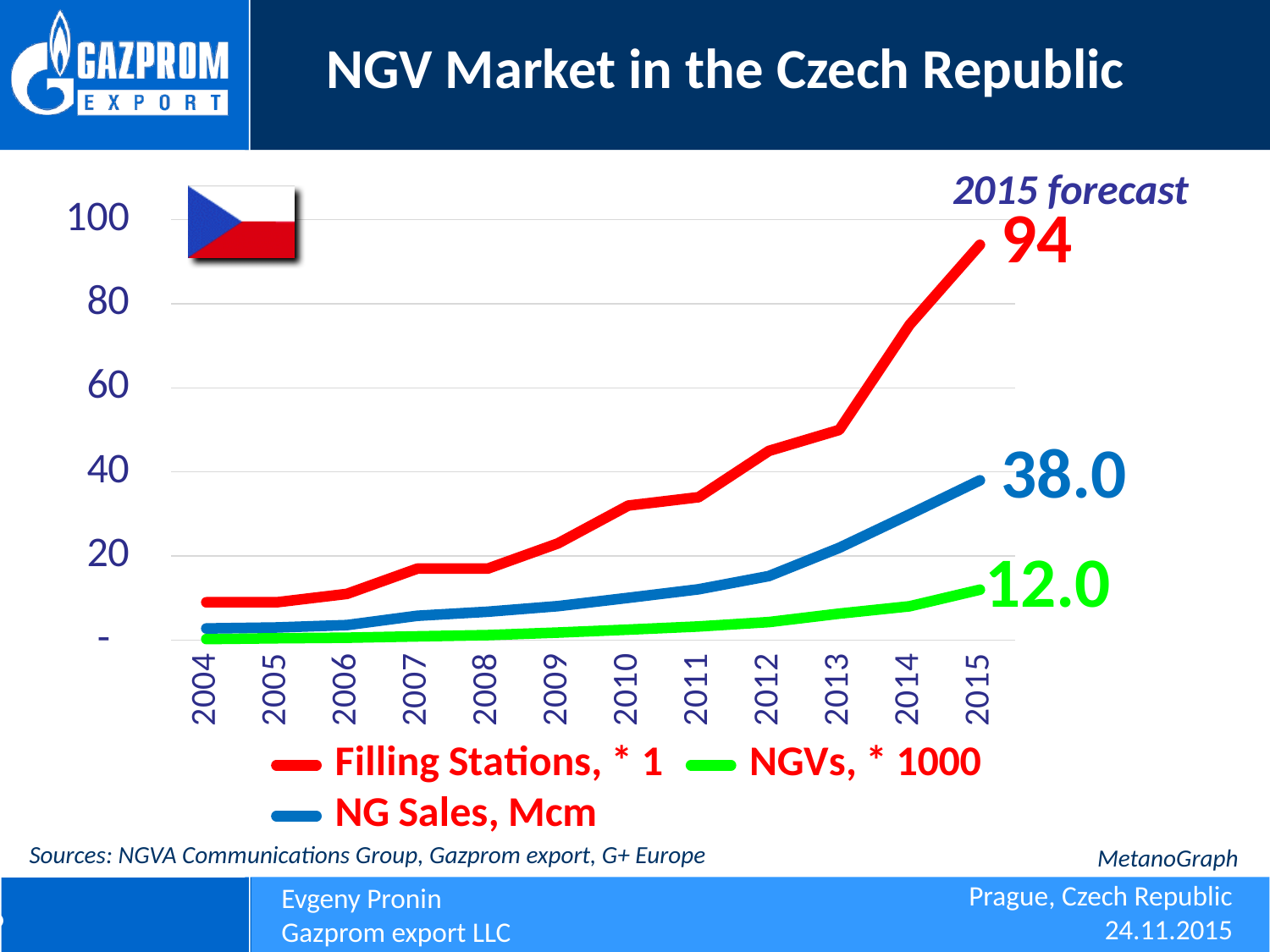
How many years are shown on the x axis? 12 Is the value for Filling Stations, * 1 in 2013 greater or less than 40? greater Is the value for NG Sales, Mcm in 2012 greater or less than 20? less In 2015, which is larger: Filling Stations, * 1 or NG Sales, Mcm? Filling Stations, * 1 Which series has the lowest value in 2015? NGVs, * 1000 What is the 2015 forecast value for Filling Stations, * 1? 94 What is the difference between the 2015 values for NG Sales, Mcm and NGVs, * 1000? 26.0 What is the 2015 forecast value for NG Sales, Mcm? 38.0 Which series has the highest value in 2015? Filling Stations, * 1 How many series does the legend list? 3 What is the 2015 forecast value for NGVs, * 1000? 12.0 What kind of chart is shown on the slide? line chart